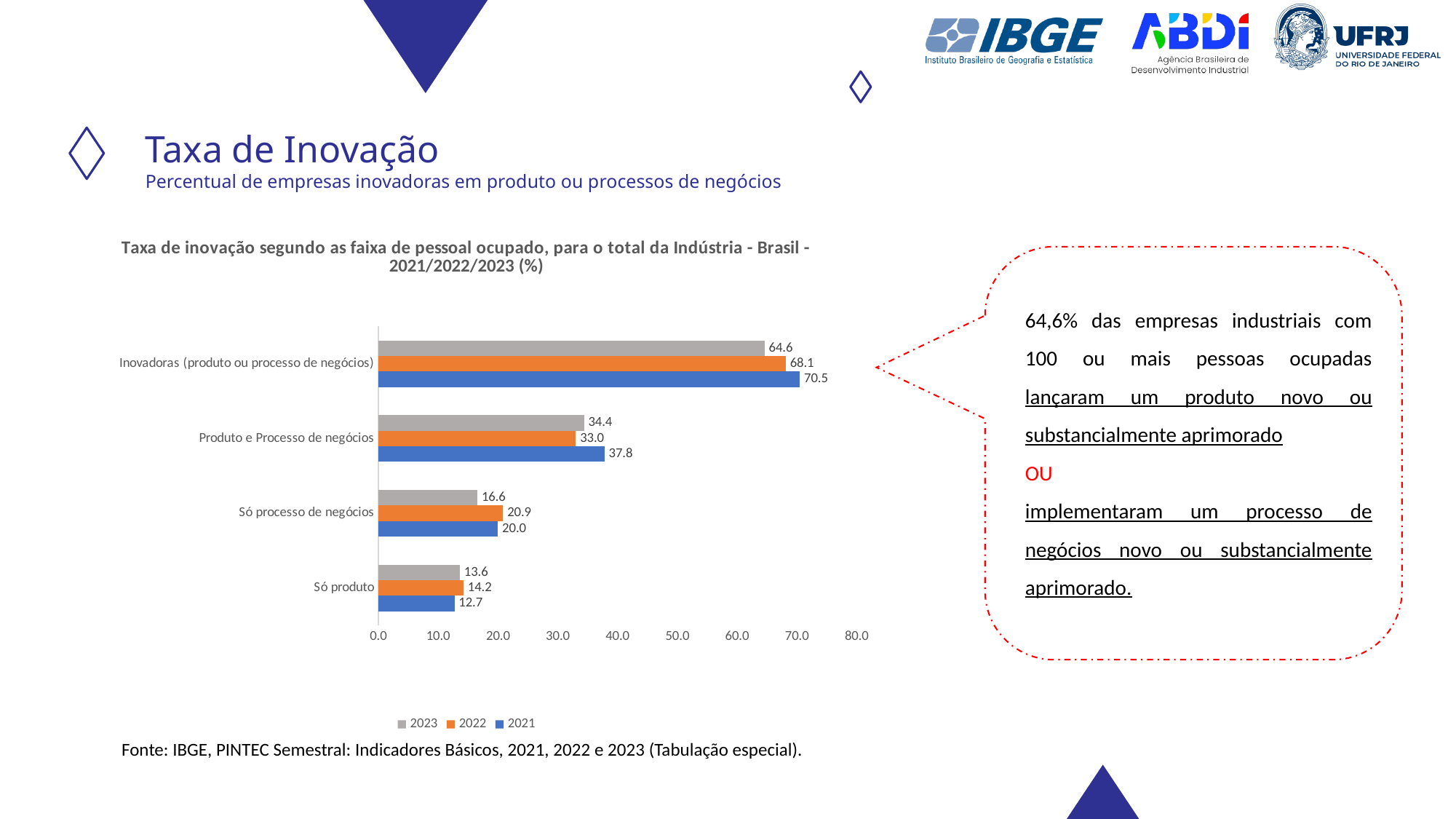
What kind of chart is shown? Bar chart What is the 2021 value for Só produto? 12.7 Which category has the highest 2021 value? Inovadoras (produto ou processo de negócios) What is the 2021 value for Produto e Processo de negócios? 37.8 How many series does the legend list? 3 What is the 2022 value for Só processo de negócios? 20.9 How many categories are shown on the y axis? 4 What is the difference between the 2021 and 2023 values for Inovadoras (produto ou processo de negócios)? 5.9 What is the 2023 value for Inovadoras (produto ou processo de negócios)? 64.6 Which colour represents the 2022 series in the legend? Orange For Só processo de negócios, which year has the larger value, 2022 or 2023? 2022 Which category has the lowest 2023 value? Só produto